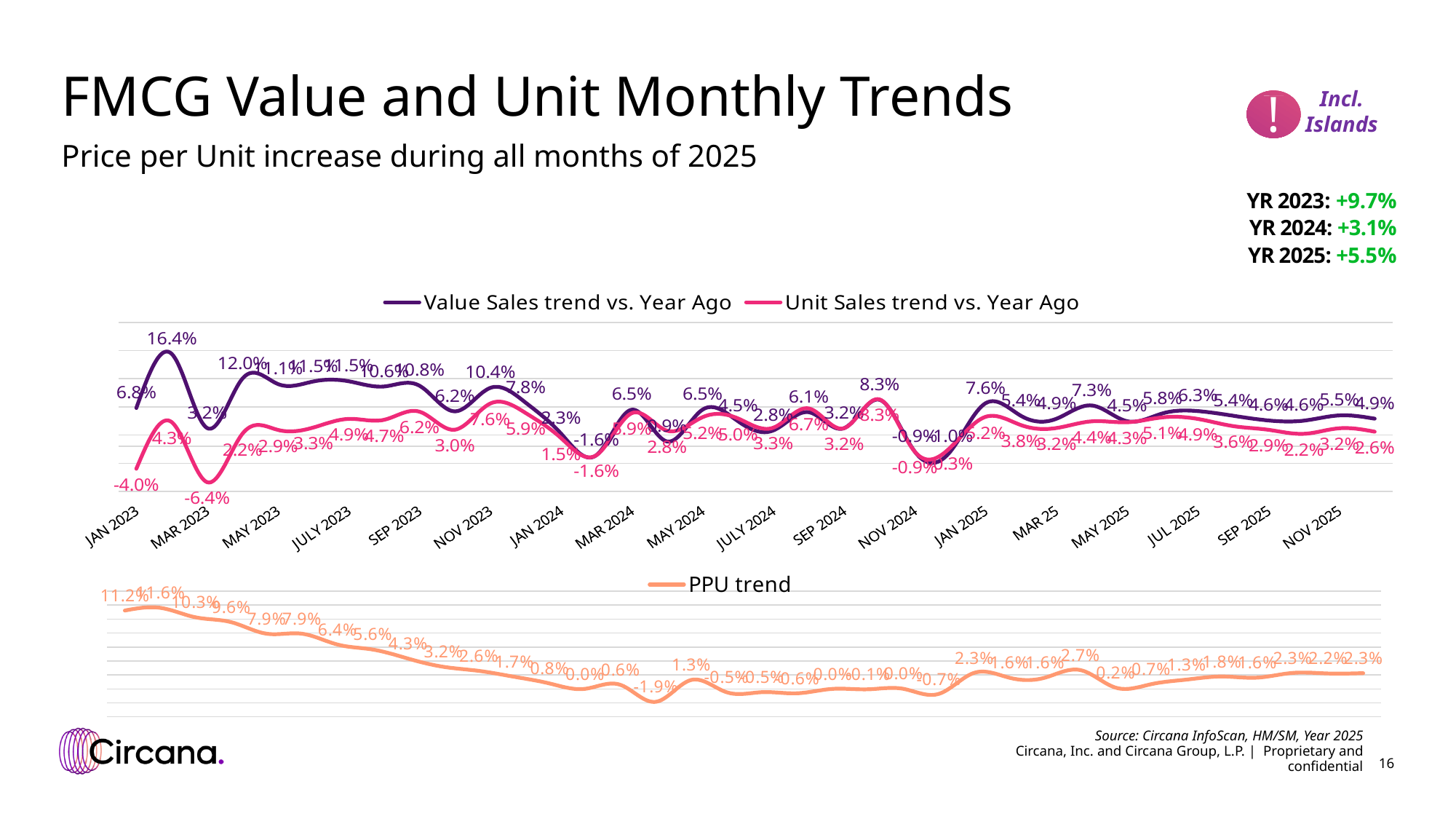
In the top chart, what is the lowest value reached by the Unit Sales trend vs. Year Ago line? -6.4% In the top chart, what is the Value Sales trend vs. Year Ago for NOV 2023? 10.4% In the bottom chart, does the PPU trend rise or fall over the course of 2023? Fall In the top chart, what is the difference between the Value Sales trend and the Unit Sales trend for JAN 2023? 10.8 percentage points In the bottom chart, what is the PPU trend value for JAN 2023? 11.2% In the top chart, which is larger for NOV 2025: the Value Sales trend or the Unit Sales trend? Value Sales trend In the top chart, what is the Value Sales trend vs. Year Ago for JAN 2023? 6.8% In the bottom chart, what is the lowest PPU trend value shown? -1.9% In the top chart, what is the Unit Sales trend vs. Year Ago for MAR 2023? -6.4% In the top chart, what is the highest value reached by the Value Sales trend vs. Year Ago line? 16.4% How many series does the legend of the top chart list? 2 What kind of chart is the bottom PPU trend chart? Line chart